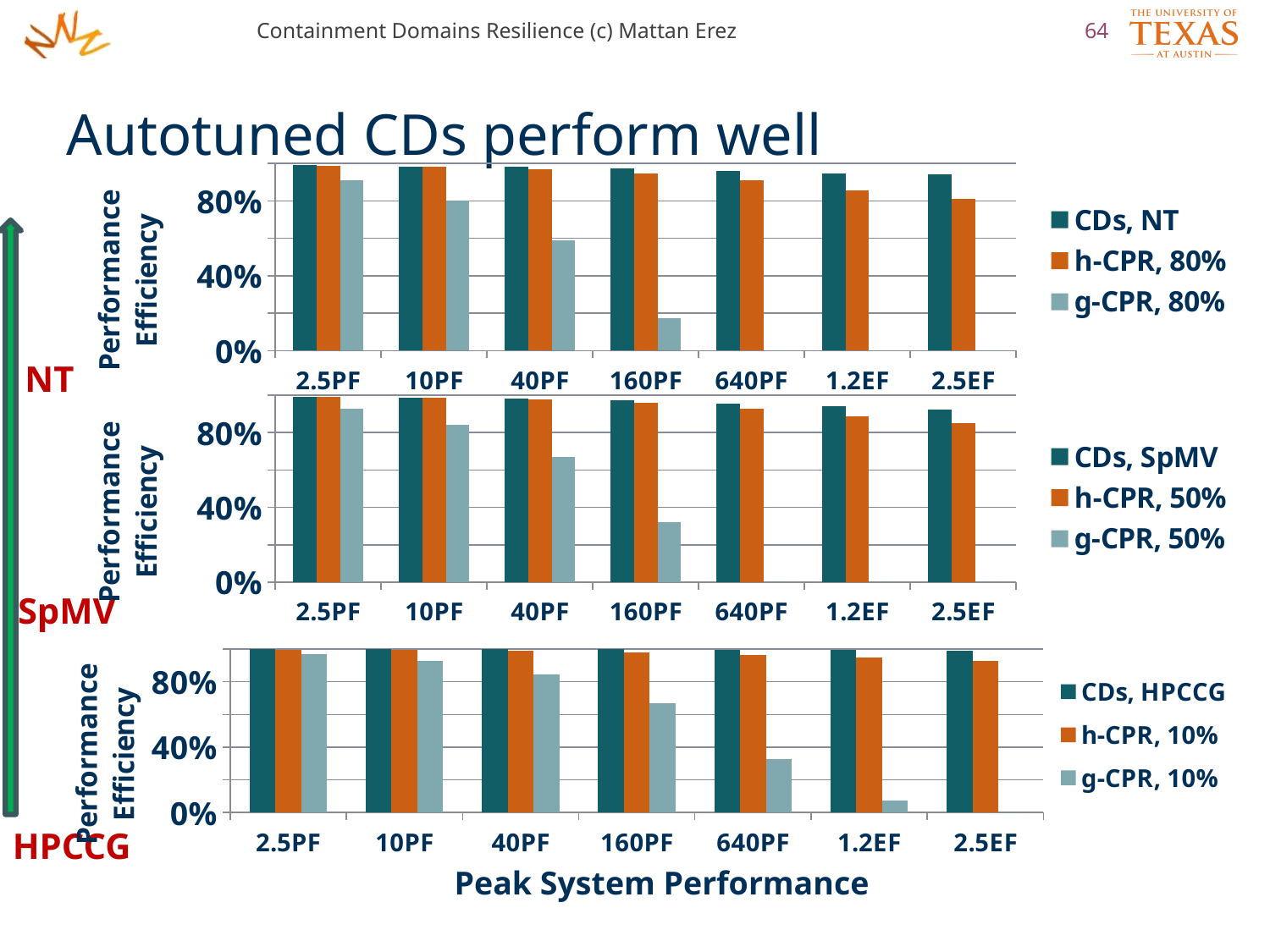
What kind of chart is the top chart (with legend CDs, NT)? bar chart What are the three legend entries of the bottom chart? CDs, HPCCG; h-CPR, 10%; g-CPR, 10% In the top chart (CDs, NT), is the value for g-CPR, 80% at 40PF greater or less than 40%? greater In the middle chart (CDs, SpMV), how many series does the legend list? 3 In the middle chart (CDs, SpMV), is the value for g-CPR, 50% at 10PF greater or less than 80%? greater In the top chart (CDs, NT), which is larger at 160PF: CDs, NT or g-CPR, 80%? CDs, NT In the bottom chart (CDs, HPCCG), is the value for g-CPR, 10% at 640PF greater or less than 40%? less What is the x-axis title shown under the bottom chart? Peak System Performance In the top chart (CDs, NT), how many peak system performance categories are shown on the x axis? 7 In the bottom chart (CDs, HPCCG), do the g-CPR, 10% values rise or fall as peak system performance increases along the x axis? fall In the bottom chart (CDs, HPCCG), which is larger at 640PF: h-CPR, 10% or g-CPR, 10%? h-CPR, 10%